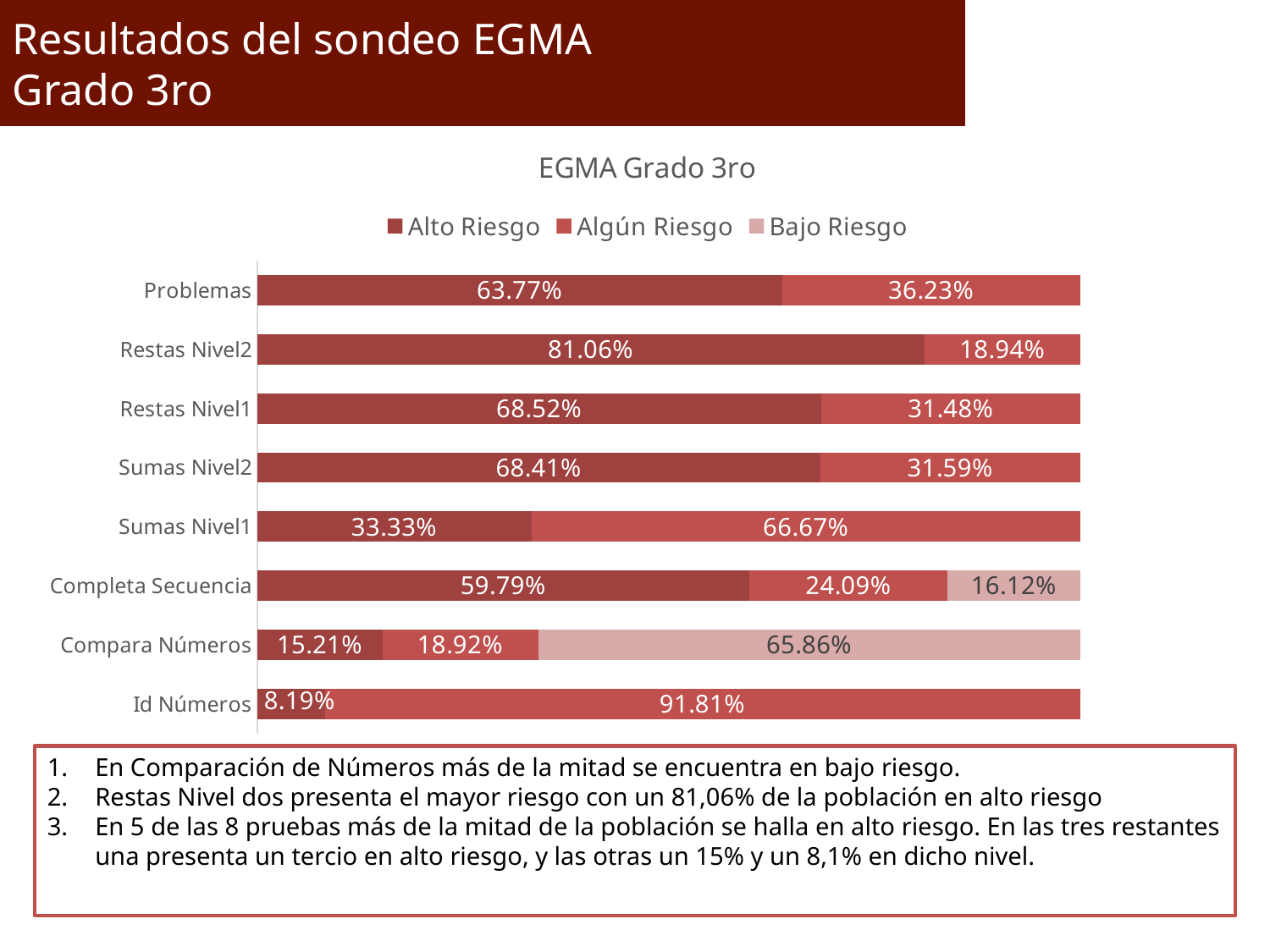
What is the Bajo Riesgo value for Compara Números? 65.86% Which is larger for Sumas Nivel1: the Alto Riesgo value or the Algún Riesgo value? Algún Riesgo What is the Alto Riesgo value for Restas Nivel2? 81.06% How many series does the legend list? 3 What is the difference between the Alto Riesgo and Algún Riesgo values for Problemas? 27.54% What is the Algún Riesgo value for Sumas Nivel1? 66.67% Which category has the lowest Alto Riesgo value? Id Números Which category has the highest Alto Riesgo value? Restas Nivel2 Which category has the highest Algún Riesgo value? Id Números What kind of chart is shown on the slide? Stacked bar chart How many categories are shown on the y axis of the chart? 8 What is the Bajo Riesgo value for Completa Secuencia? 16.12%